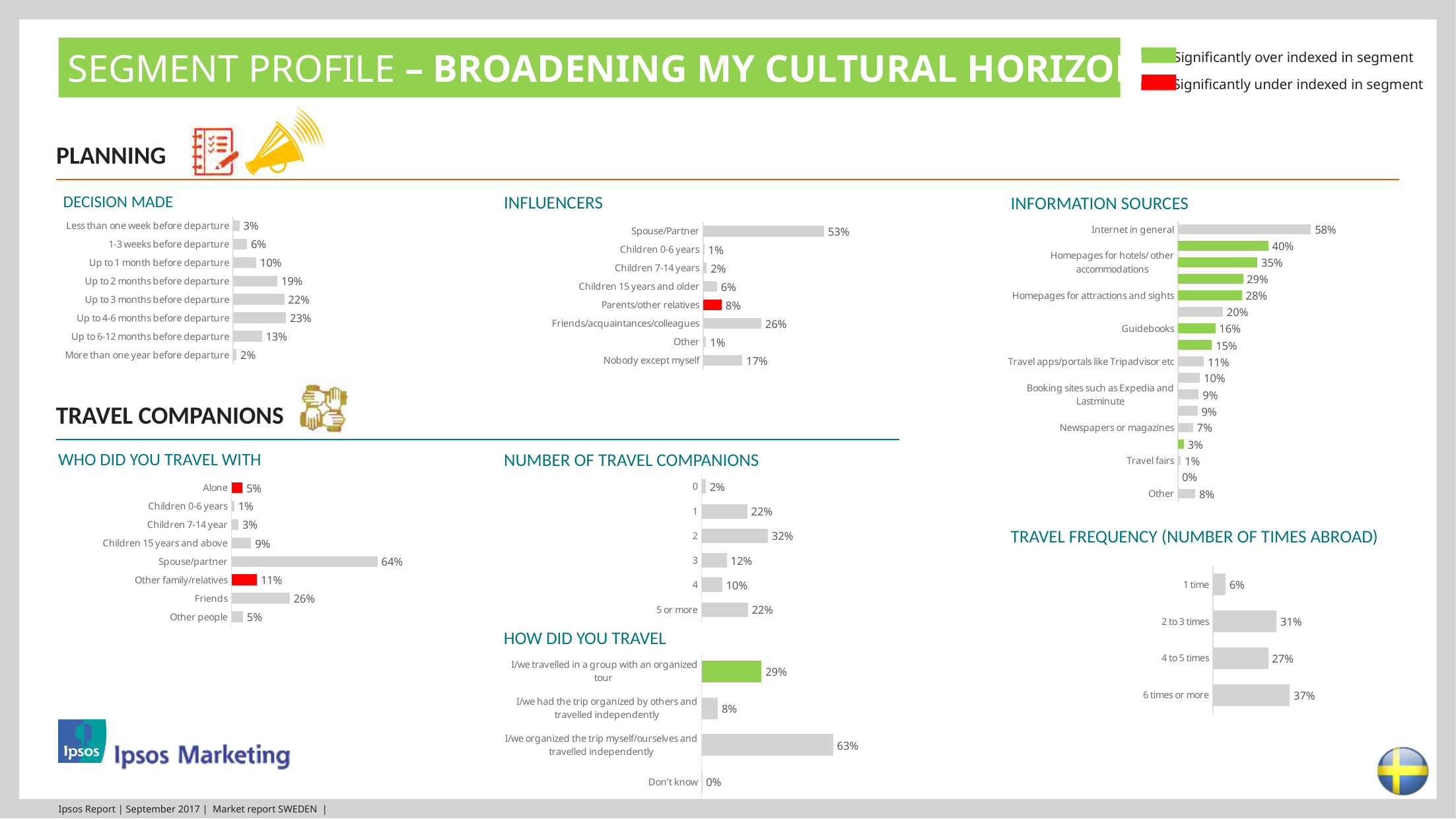
In the 'Influencers' chart, what is the value for 'Spouse/Partner'? 53% In the 'Travel frequency (number of times abroad)' chart, what is the difference between '6 times or more' and '2 to 3 times'? 6% In the 'Who did you travel with' chart, which is larger: 'Friends' or 'Other family/relatives'? Friends In the 'Information sources' chart, what is the value for 'Guidebooks'? 16% In the 'Decision made' chart, which category has the lowest value? More than one year before departure In the 'Information sources' chart, which category has the highest value? Internet in general In the 'Number of travel companions' chart, how many categories are shown? 6 In the 'Decision made' chart, what is the value for 'Up to 4-6 months before departure'? 23% In the 'Influencers' chart, what is the difference between 'Friends/acquaintances/colleagues' and 'Nobody except myself'? 9% In the 'Number of travel companions' chart, which category has the highest value? 2 In the 'How did you travel' chart, what is the value for 'I/we organized the trip myself/ourselves and travelled independently'? 63% In the 'Who did you travel with' chart, what is the value for 'Spouse/partner'? 64%